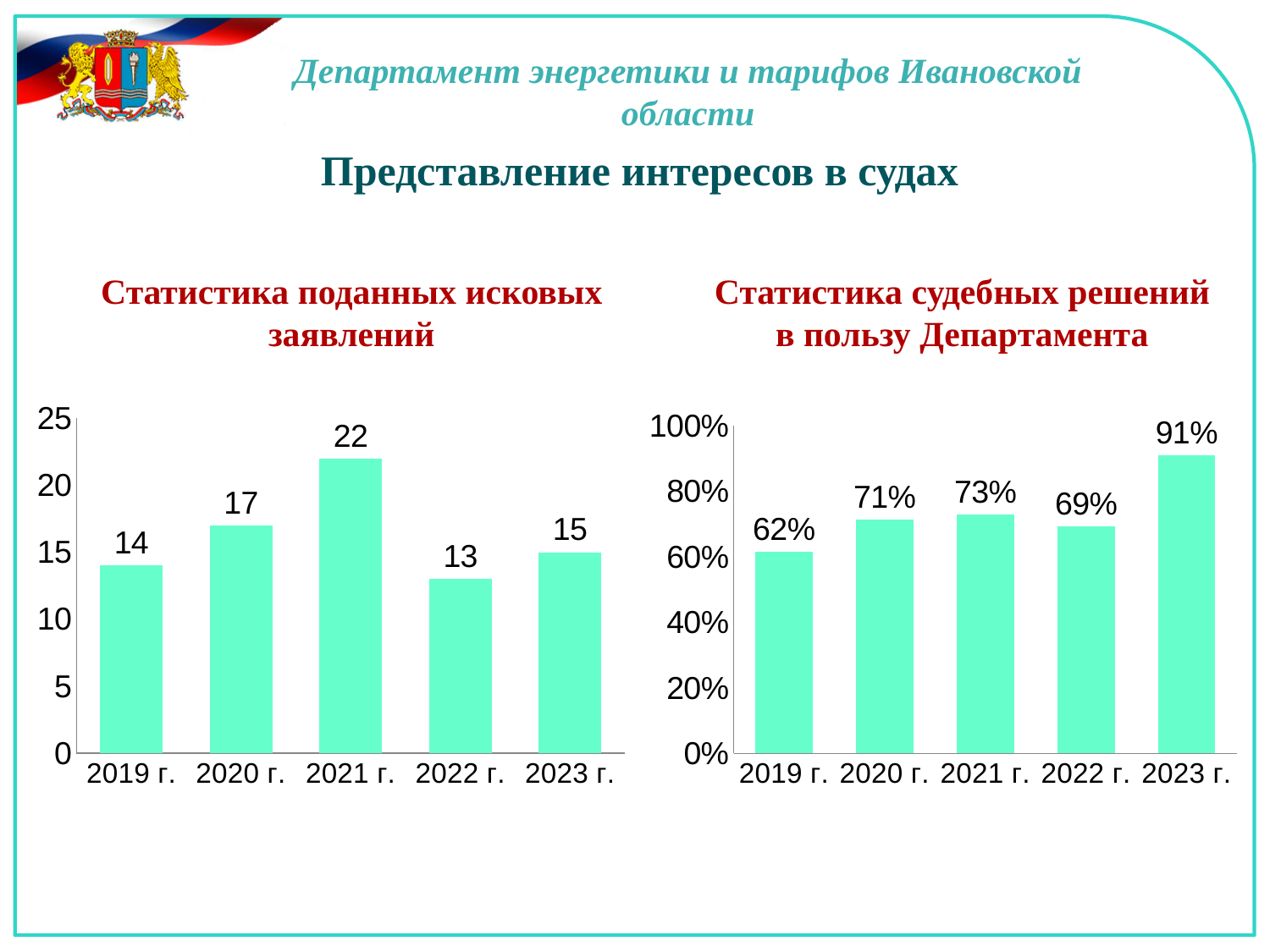
In the left chart (Статистика поданных исковых заявлений), what is the difference between the values for 2021 г. and 2022 г.? 9 In the left chart (Статистика поданных исковых заявлений), what is the value for 2023 г.? 15 In the left chart (Статистика поданных исковых заявлений), is the value for 2020 г. greater or less than 15? greater In the right chart (Статистика судебных решений в пользу Департамента), which year has the highest value? 2023 г. What type of chart is the right chart (Статистика судебных решений в пользу Департамента)? bar chart In the left chart (Статистика поданных исковых заявлений), how many years are shown on the x axis? 5 In the right chart (Статистика судебных решений в пользу Департамента), which is larger: the value for 2021 г. or 2022 г.? 2021 г. In the left chart (Статистика поданных исковых заявлений), what is the value for 2021 г.? 22 In the right chart (Статистика судебных решений в пользу Департамента), what is the difference between the values for 2023 г. and 2022 г.? 22% In the left chart (Статистика поданных исковых заявлений), which year has the lowest value? 2022 г. What is the title of the left chart? Статистика поданных исковых заявлений In the right chart (Статистика судебных решений в пользу Департамента), what is the value for 2019 г.? 62%